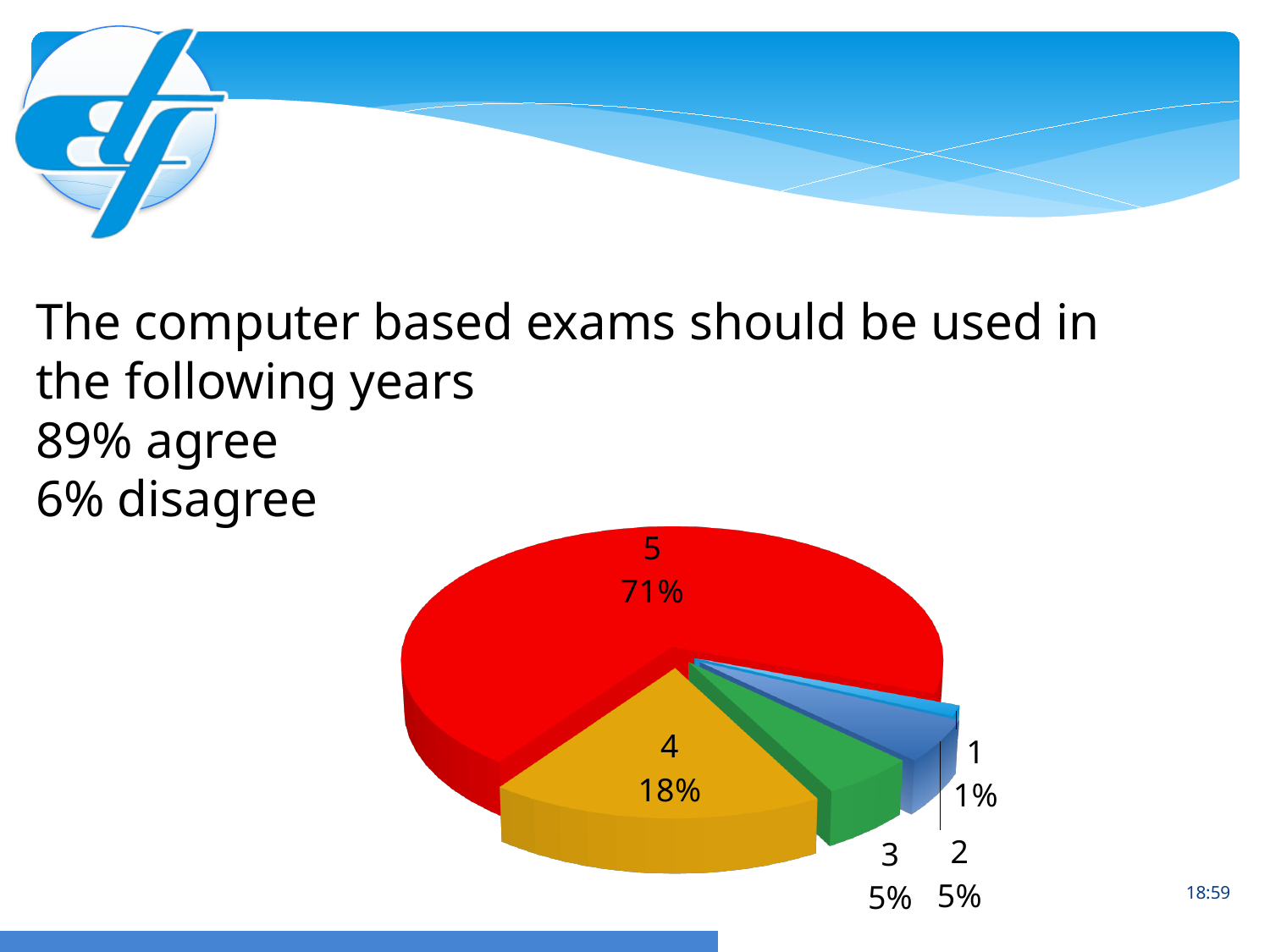
What is the combined share of categories 4 and 5? 89% What colour is the slice for category 5? red Which category has the largest slice of the pie? 5 How many slices does the pie chart have? 5 What share of the pie does category 3 have? 5% What is the difference in percentage points between category 5 and category 4? 53% What share of the pie does category 5 have? 71% Which category has the smallest slice of the pie? 1 Which is larger, the slice for category 4 or the slice for category 2? 4 What kind of chart is shown on the slide? pie chart What share of the pie does category 4 have? 18% What share of the pie does category 1 have? 1%